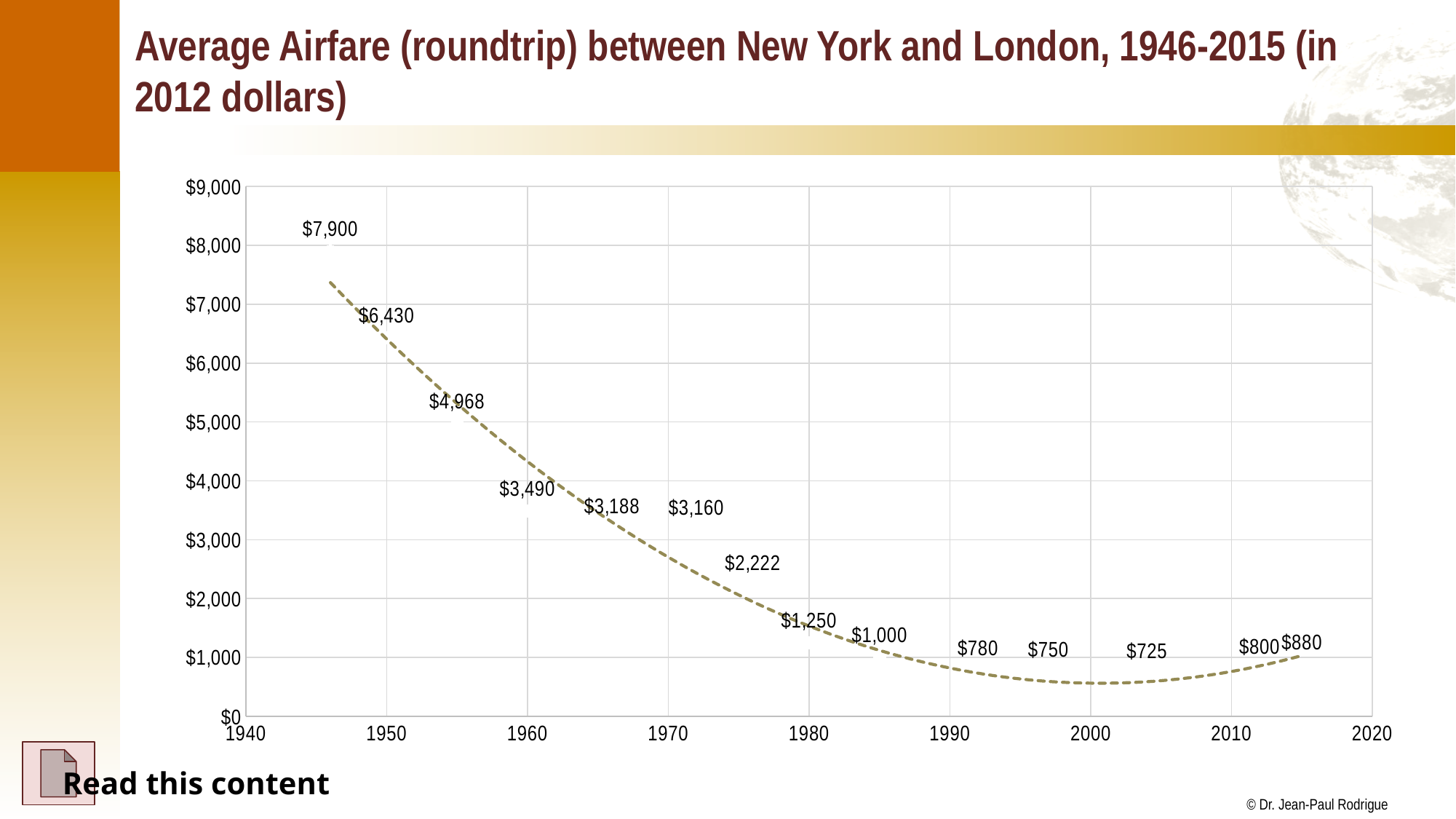
What is the average airfare shown for 1946, the first year in the series? $7,900 What is the average airfare shown for 2015, the last year in the series? $880 How many data points are labelled on the chart? 14 What is the lowest airfare value labelled on the chart? $725 Which is larger, the $3,188 point or the $3,160 point? $3,188 Is the airfare value labelled $2,222 greater or less than $2,000 on the axis? greater Overall, do the airfare values rise or fall from 1946 to the 2000s? fall What is the highest airfare value labelled on the chart? $7,900 What is the difference between the highest labelled airfare ($7,900) and the lowest labelled airfare ($725)? $7,175 What is the difference between the first labelled value ($7,900) and the last labelled value ($880)? $7,020 What is the title of the chart? Average Airfare (roundtrip) between New York and London, 1946-2015 (in 2012 dollars) What kind of chart is shown on the slide? scatter chart with a dashed trend line